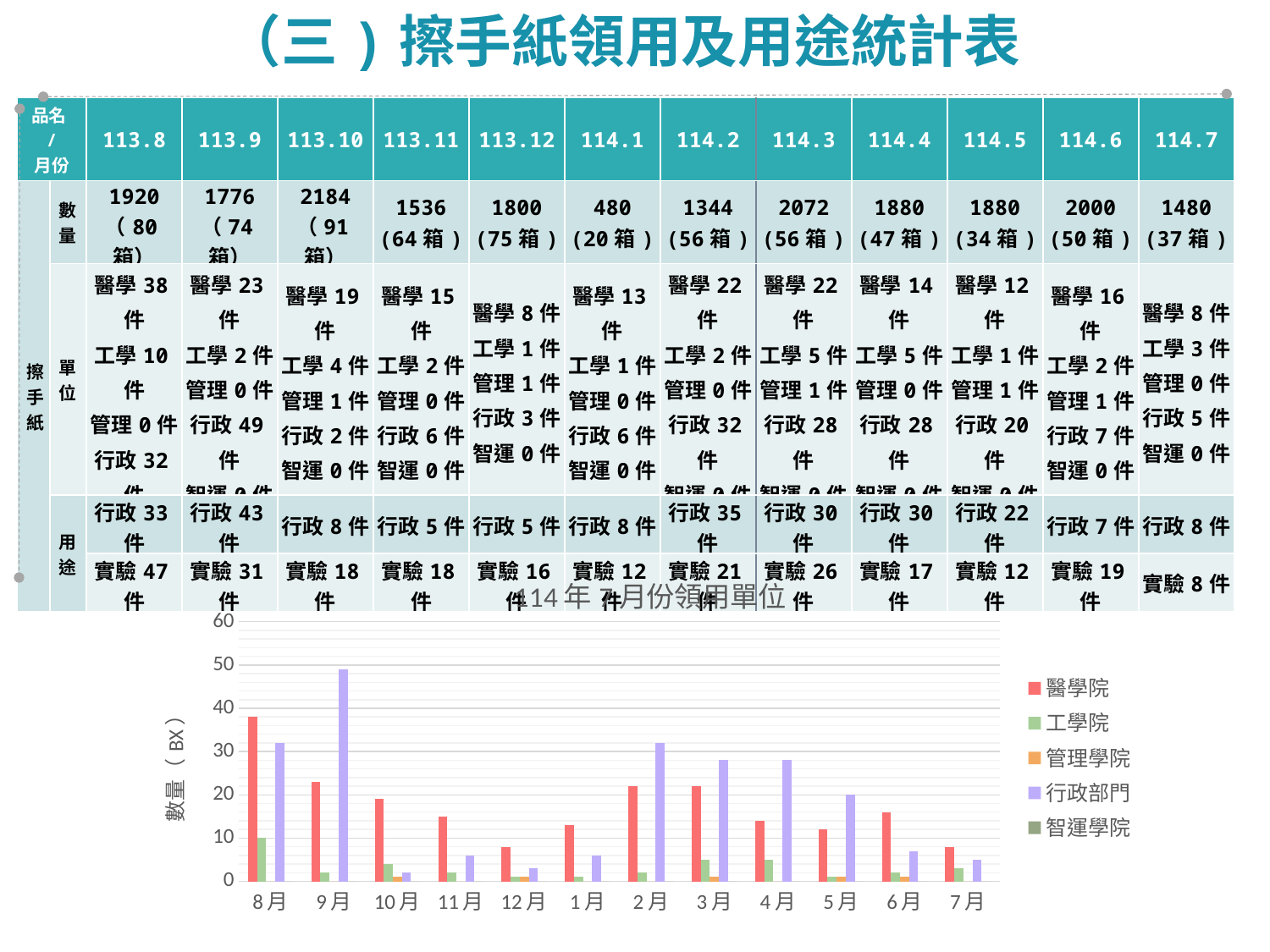
In the bar chart, in which month is the value for 行政部門 highest? 9月 In the bar chart, in which month is the value for 醫學院 highest? 8月 In the bar chart, which is larger in 9月: 醫學院 or 行政部門? 行政部門 How many months are shown on the x axis of the bar chart? 12 What is the label on the y axis of the bar chart? 數量（BX） In the bar chart, is the value for 醫學院 in 8月 greater or less than 30? greater In the bar chart, is the value for 行政部門 in 9月 greater or less than 40? greater What kind of chart is shown at the bottom of the slide? bar chart In the bar chart, is the value for 行政部門 in 10月 greater or less than 10? less In the bar chart, do the values for 醫學院 rise or fall from 8月 to 12月? fall In the bar chart, which is larger in 8月: 醫學院 or 行政部門? 醫學院 How many series does the legend of the bar chart list? 5